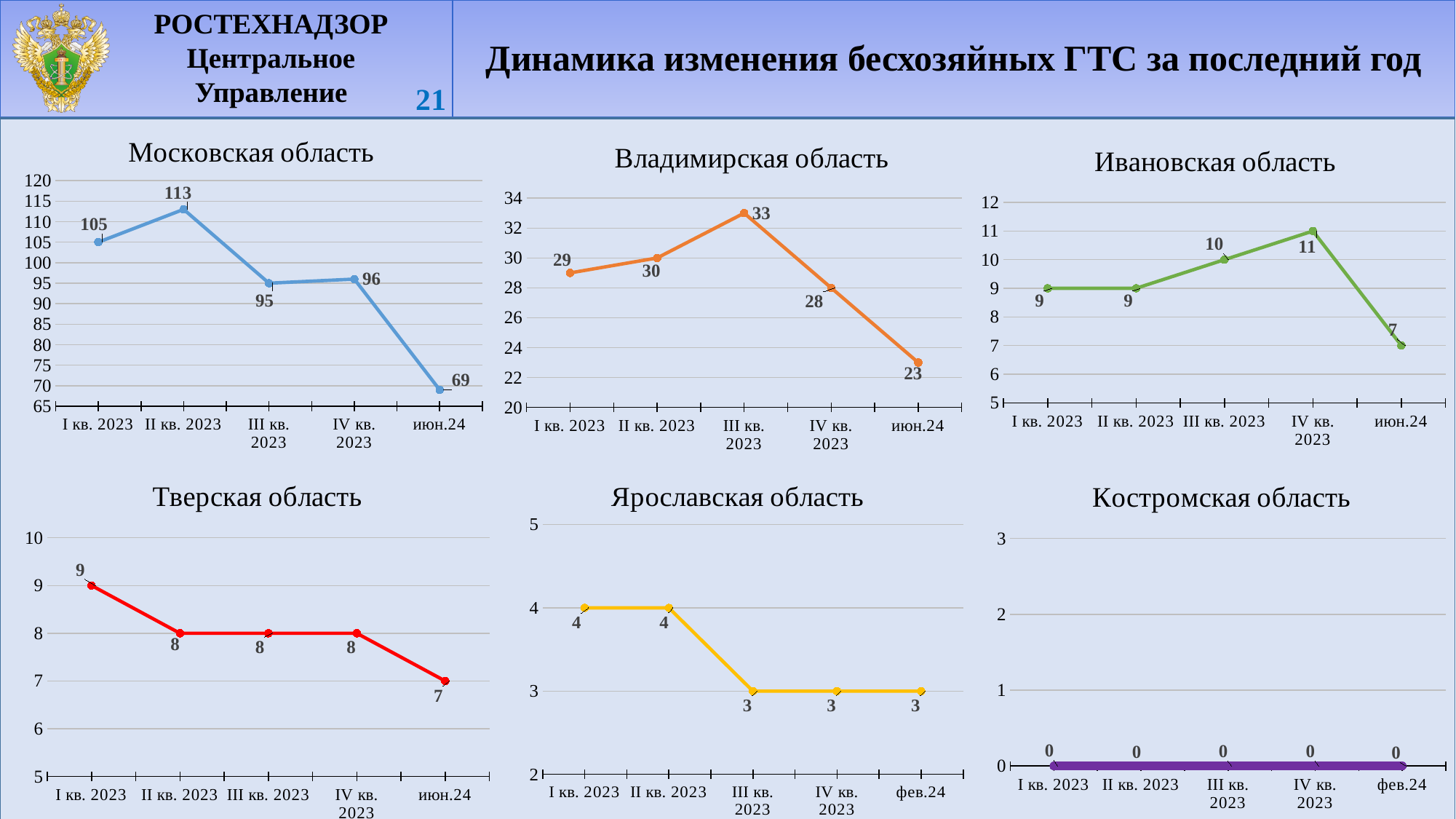
In the Тверская область chart, what is the value for I кв. 2023? 9 In the Владимирская область chart, what is the value for IV кв. 2023? 28 In the Владимирская область chart, which period has the highest value? III кв. 2023 In the Ярославская область chart, which is larger, the value for II кв. 2023 or the value for фев.24? II кв. 2023 In the Московская область chart, what is the value for июн.24? 69 In the Московская область chart, what is the value for II кв. 2023? 113 How many data points does the Тверская область chart have? 5 In the Ивановская область chart, which period has the lowest value? июн.24 In the Ивановская область chart, what is the difference between the values for IV кв. 2023 and июн.24? 4 In the Костромская область chart, what is the value for фев.24? 0 What type of chart is the Московская область chart? Line chart In the Московская область chart, what is the difference between the values for I кв. 2023 and июн.24? 36